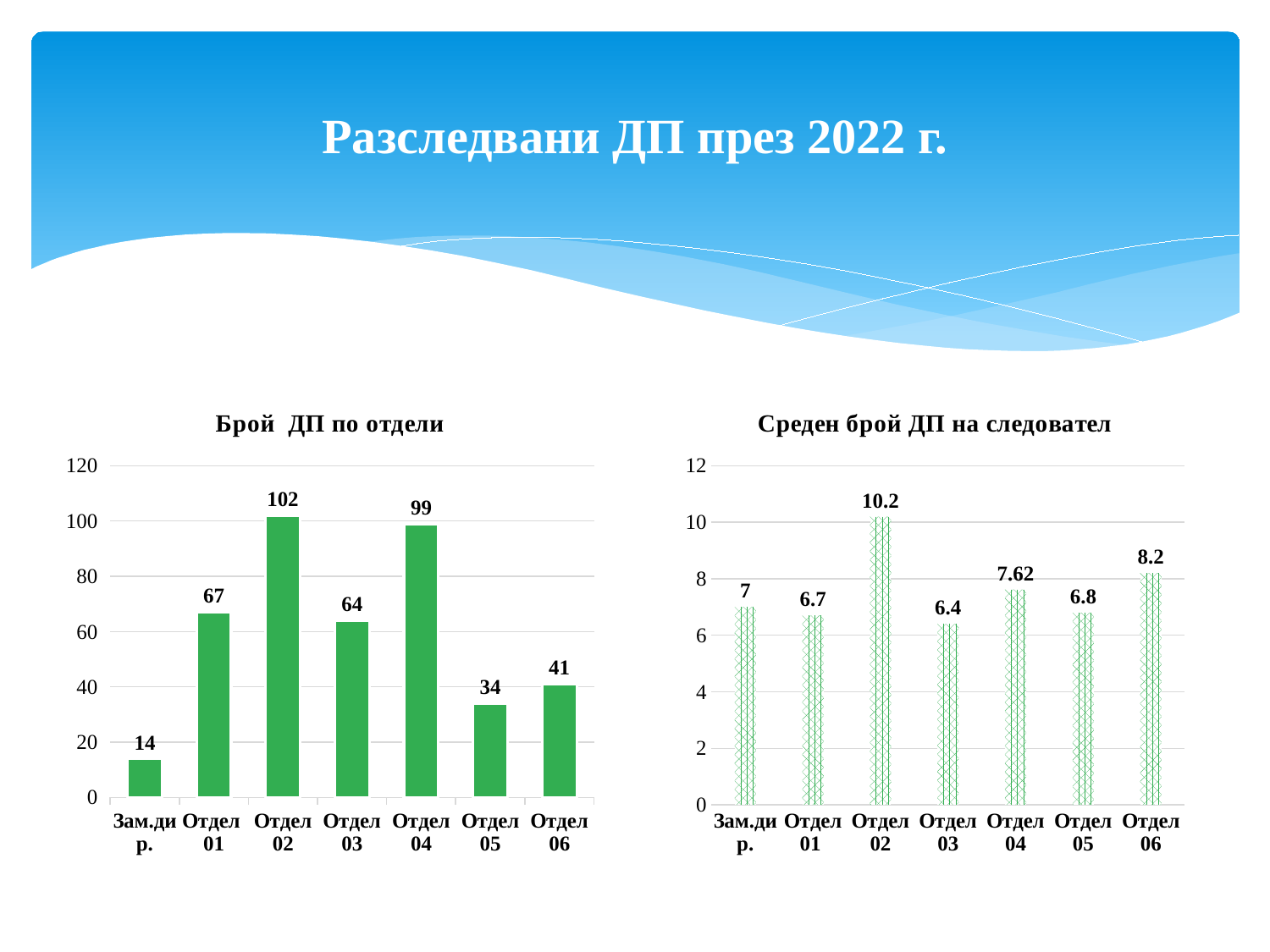
In the chart titled "Среден брой ДП на следовател", what is the value for Отдел 04? 7.62 In the chart titled "Брой ДП по отдели", what is the value for Отдел 02? 102 In the chart titled "Брой ДП по отдели", how many categories are shown on the x axis? 7 In the chart titled "Брой ДП по отдели", which category has the lowest value? Зам.дир. In the chart titled "Среден брой ДП на следовател", which category has the lowest value? Отдел 03 In the chart titled "Брой ДП по отдели", which is larger, the value for Отдел 01 or Отдел 03? Отдел 01 In the chart titled "Среден брой ДП на следовател", which category has the highest value? Отдел 02 In the chart titled "Брой ДП по отдели", which category has the highest value? Отдел 02 What kind of chart is the chart titled "Среден брой ДП на следовател"? Bar chart What is the title of the chart on the left side of the slide? Брой ДП по отдели In the chart titled "Брой ДП по отдели", what is the difference between the values for Отдел 04 and Отдел 05? 65 In the chart titled "Среден брой ДП на следовател", what is the difference between the values for Отдел 06 and Отдел 01? 1.5